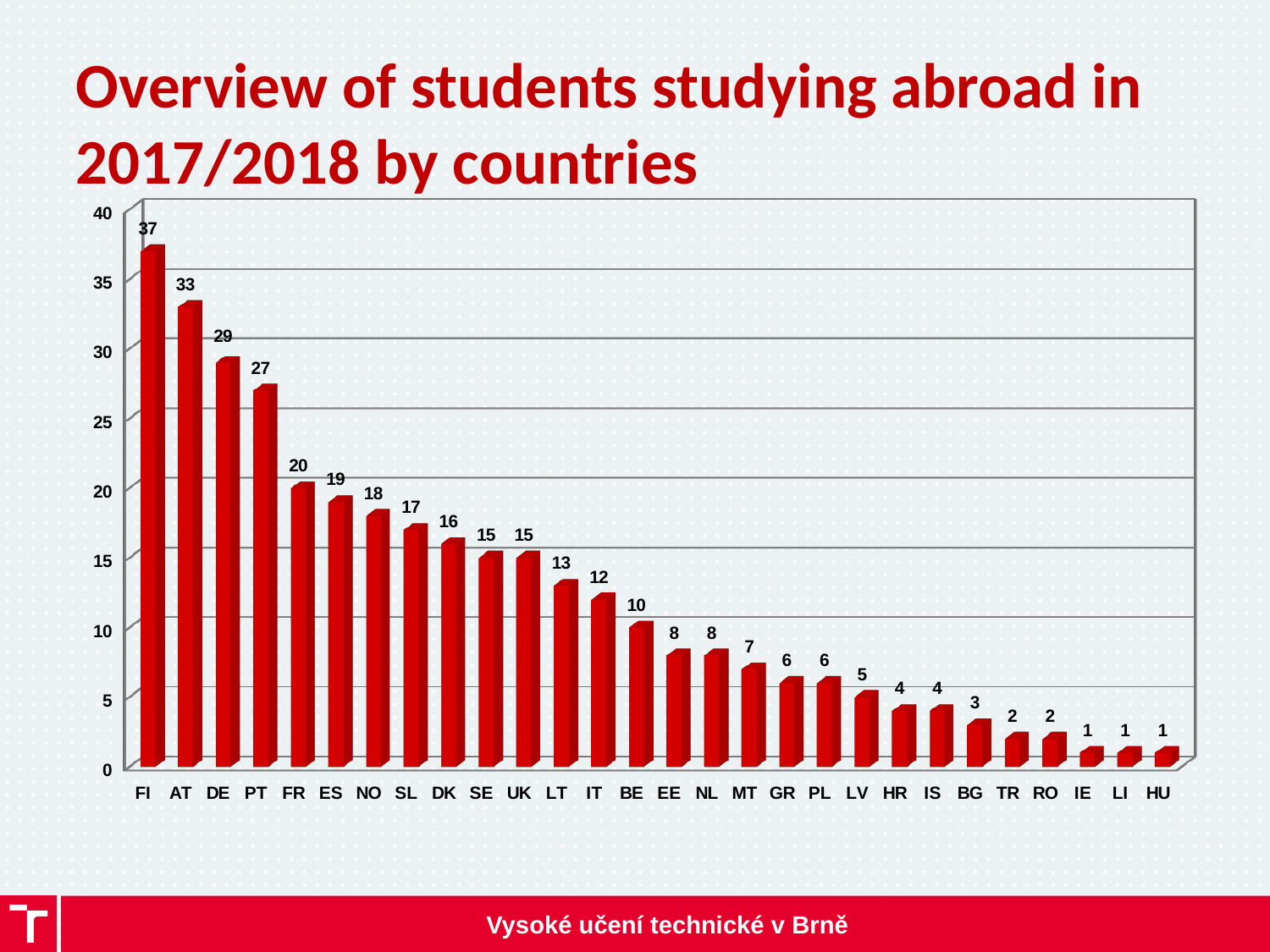
How many countries are shown on the x axis of the chart? 28 What is the value shown for Portugal (PT)? 27 How many students studied abroad in Finland (FI) according to the chart? 37 What is the difference between the values for AT and DE? 4 What is the difference between the values for FR and BE? 10 Do the values rise or fall moving from left to right along the x axis? Fall Which has a larger value, LV or MT? MT What is the value shown for Italy (IT)? 12 What kind of chart is shown on the slide? Bar chart Which country has the highest number of students studying abroad? FI Which has a larger value, NO or DK? NO What is the title of the chart on the slide? Overview of students studying abroad in 2017/2018 by countries